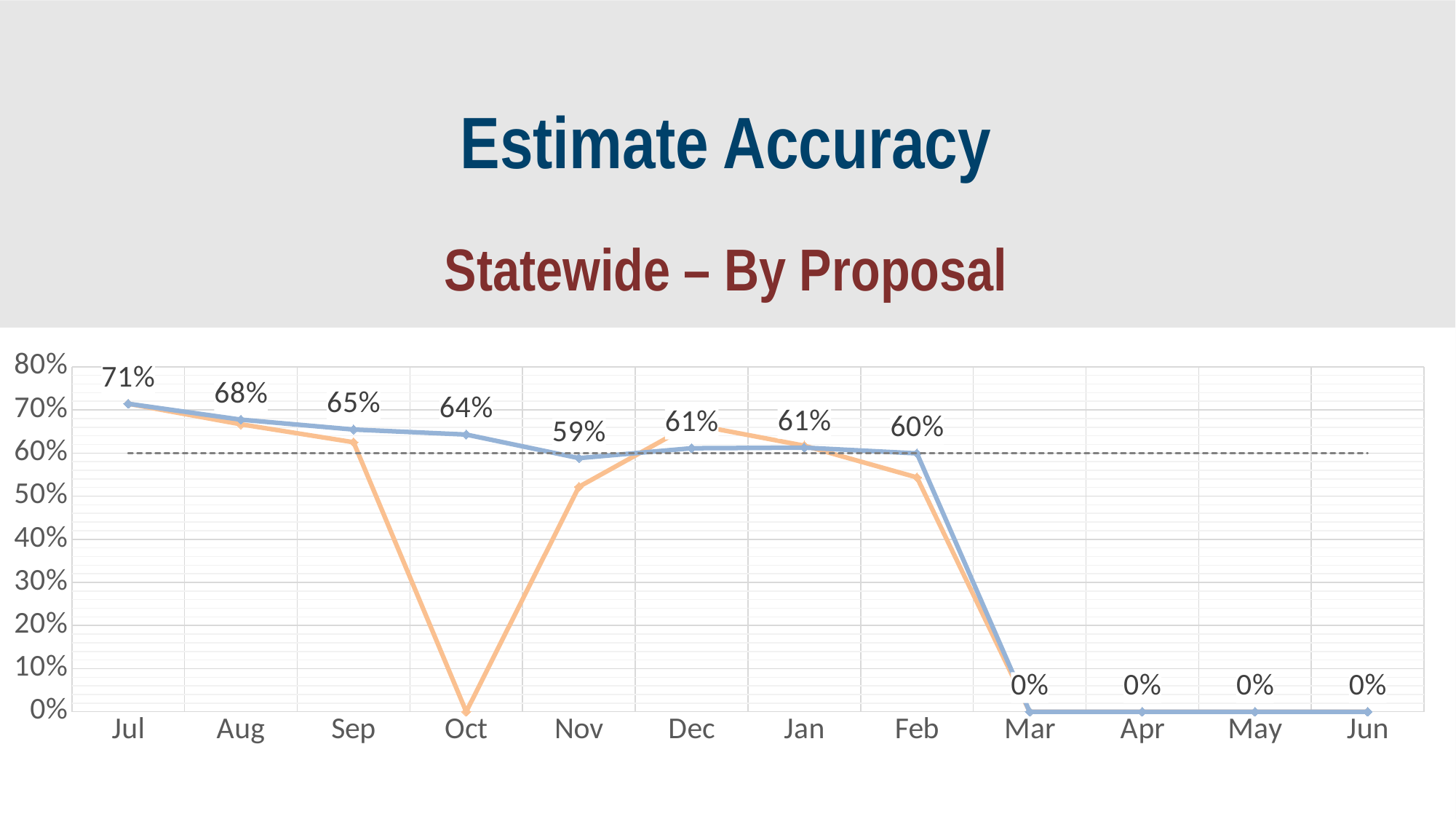
What is the labeled value for Nov on the blue line? 59% What is the labeled value for Feb on the blue line? 60% Is the value of the orange line in Sep greater or less than 50%? greater Is the value of the orange line in Oct greater or less than 10%? less What is the labeled value for Jul on the blue line? 71% What is the difference between the labeled values for Jul and Aug on the blue line? 3% What kind of chart is shown on the slide? line chart Do the labeled values on the blue line rise or fall from Jul to Nov? fall How many months are shown on the x axis of the chart? 12 Which is larger on the blue line, the labeled value for Sep or the labeled value for Jan? Sep Which month has the highest labeled value on the blue line? Jul At what percentage is the horizontal dashed reference line drawn? 60%